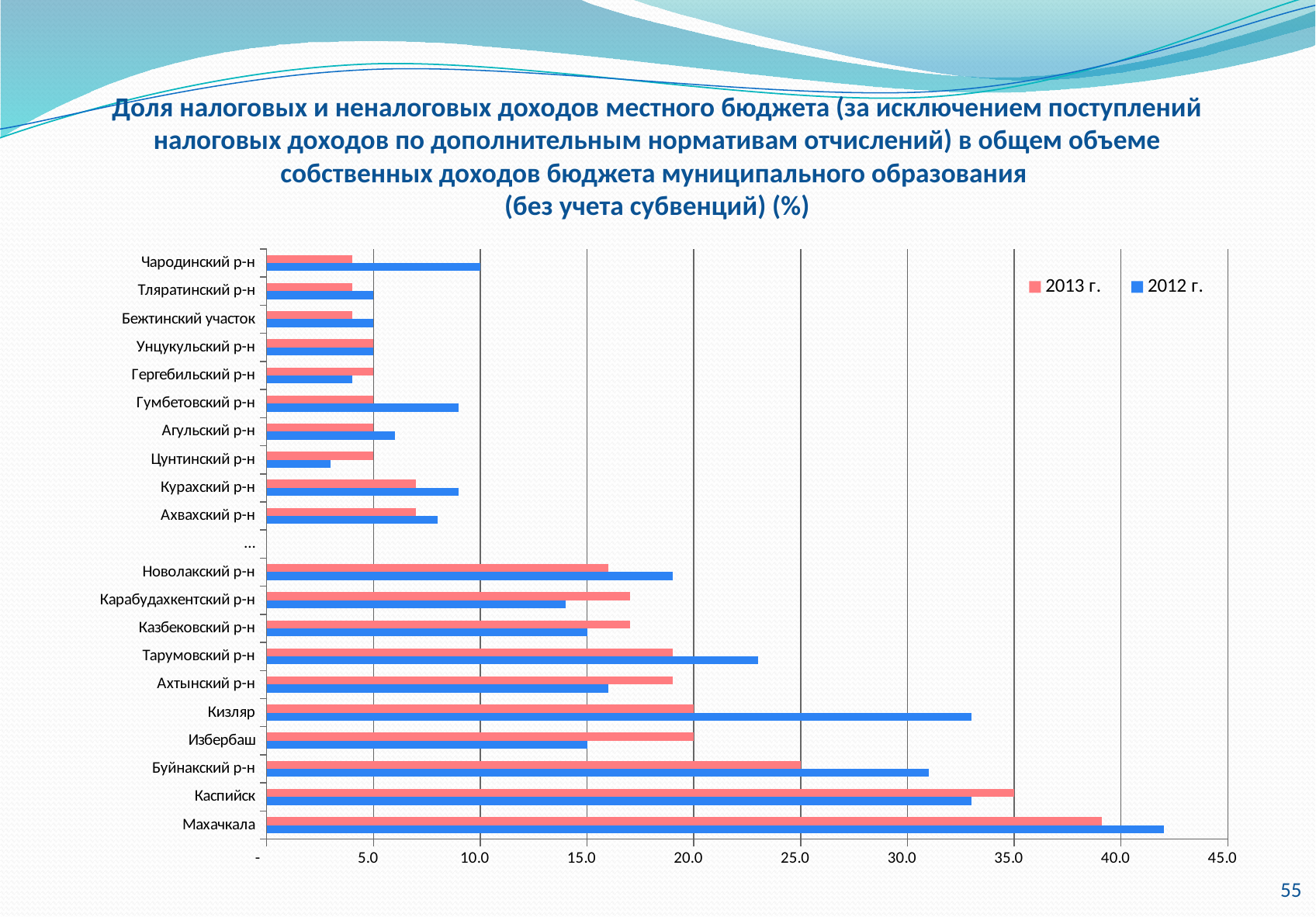
Is the 2012 г. value for Махачкала greater or less than 40.0? greater Is the 2012 г. value for Чародинский р-н greater or less than 5.0? greater What kind of chart is shown on the slide? bar chart Which municipality has the highest value for 2012 г.? Махачкала Which municipality has the lowest value for 2012 г.? Цунтинский р-н Which series is shown in blue in the legend? 2012 г. For Кизляр, which year has the larger value, 2012 г. or 2013 г.? 2012 г. Which municipality has the highest value for 2013 г.? Махачкала Is the 2012 г. value for Цунтинский р-н greater or less than 5.0? less For Карабудахкентский р-н, which year has the larger value, 2012 г. or 2013 г.? 2013 г. How many series does the legend list? 2